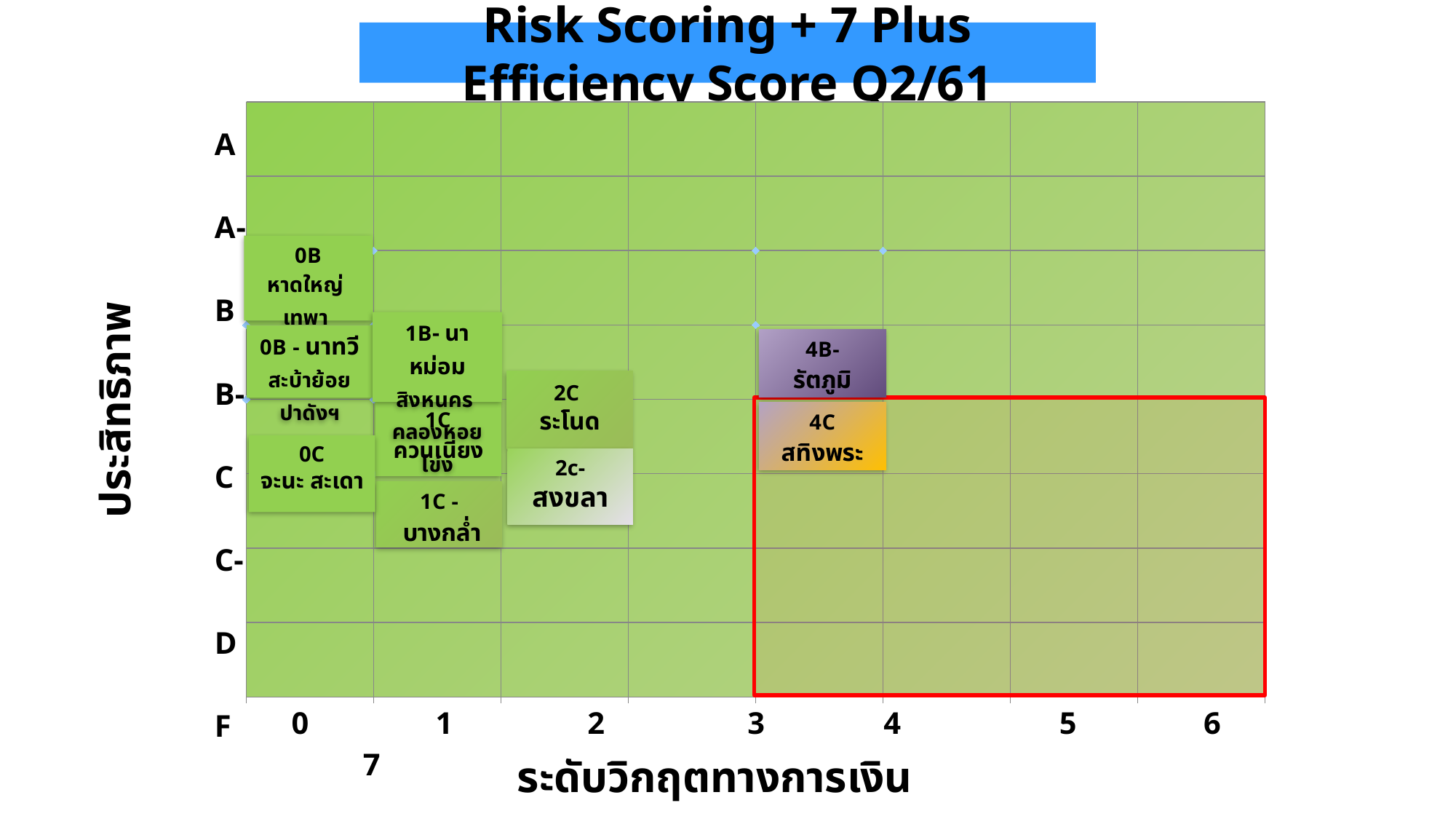
What is the title of the chart? Risk Scoring + 7 Plus Efficiency Score Q2/61 What is the label on the x axis of the chart? ระดับวิกฤตทางการเงิน What score code is shown in the box for สงขลา? 2c- What score code is shown in the box for ระโนด? 2C Which has the higher financial crisis level (x axis): สงขลา or สทิงพระ? สทิงพระ What score code is shown in the box for บางกล่ำ? 1C What score code is shown in the box for รัตภูมิ? 4B- Which has the higher efficiency grade (y axis): หาดใหญ่ or จะนะ? หาดใหญ่ Which district box lies inside the red-outlined region of the chart? 4C สทิงพระ How many labeled score boxes are plotted on the chart? 10 What score code is shown in the box for สทิงพระ? 4C